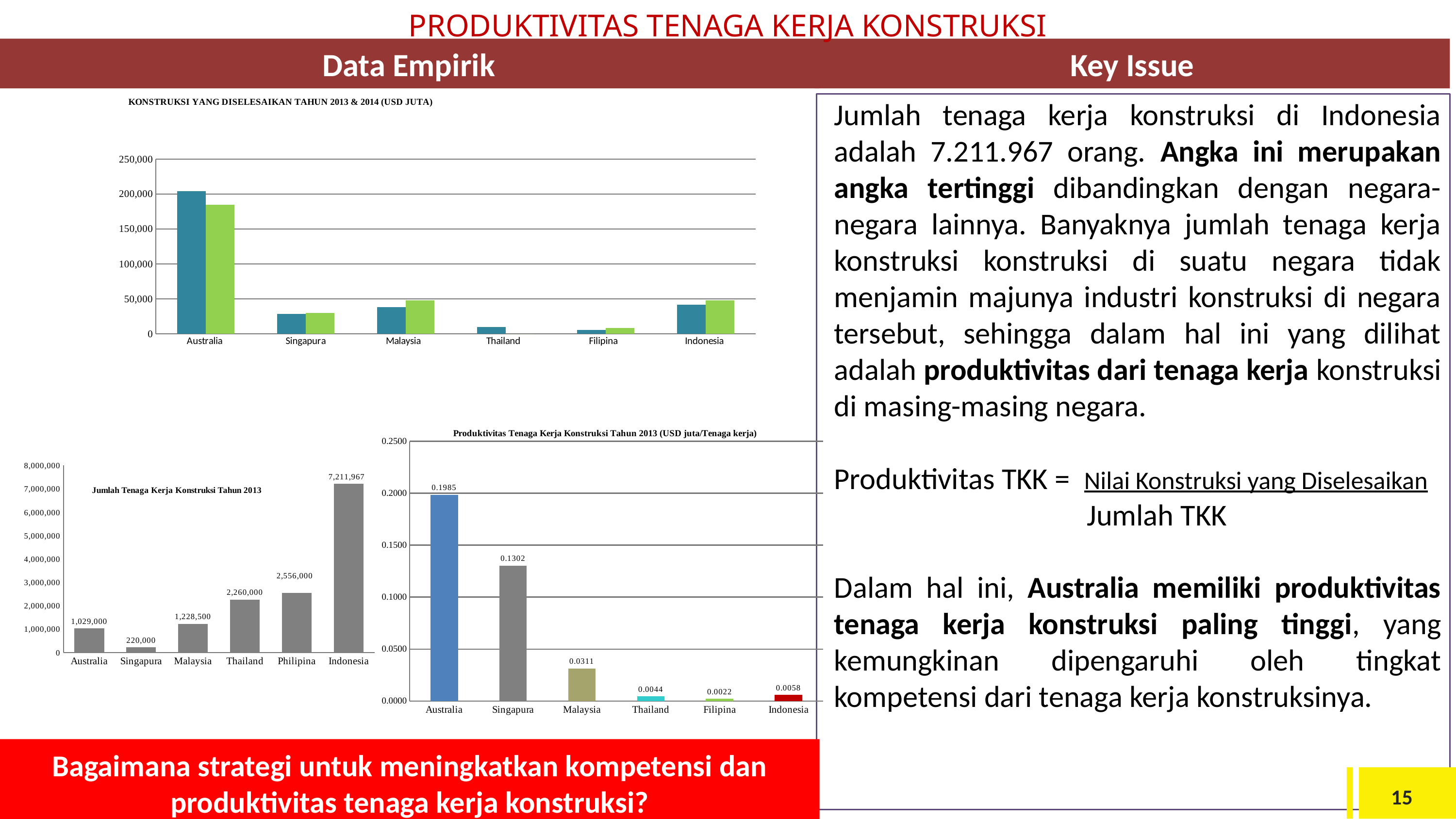
In the chart titled 'Produktivitas Tenaga Kerja Konstruksi Tahun 2013', what is the difference between the values for Australia and Singapura? 0.0683 In the top-left chart titled 'KONSTRUKSI YANG DISELESAIKAN TAHUN 2013 & 2014 (USD JUTA)', is the value of the first bar for Australia greater or less than 150,000? greater In the chart titled 'Jumlah Tenaga Kerja Konstruksi Tahun 2013', what is the value for Indonesia? 7,211,967 In the chart titled 'Jumlah Tenaga Kerja Konstruksi Tahun 2013', what is the value for Malaysia? 1,228,500 In the chart titled 'Produktivitas Tenaga Kerja Konstruksi Tahun 2013', what is the value for Singapura? 0.1302 In the chart titled 'Jumlah Tenaga Kerja Konstruksi Tahun 2013', what is the difference between the values for Philipina and Thailand? 296,000 In the chart titled 'Produktivitas Tenaga Kerja Konstruksi Tahun 2013', which country has the highest value? Australia In the chart titled 'Produktivitas Tenaga Kerja Konstruksi Tahun 2013', which is larger, the value for Thailand or the value for Indonesia? Indonesia What kind of chart is the one titled 'Produktivitas Tenaga Kerja Konstruksi Tahun 2013'? bar chart In the chart titled 'Jumlah Tenaga Kerja Konstruksi Tahun 2013', which country has the lowest value? Singapura In the top-left chart titled 'KONSTRUKSI YANG DISELESAIKAN TAHUN 2013 & 2014 (USD JUTA)', how many countries are shown on the x axis? 6 In the chart titled 'Produktivitas Tenaga Kerja Konstruksi Tahun 2013', which country has the lowest value? Filipina